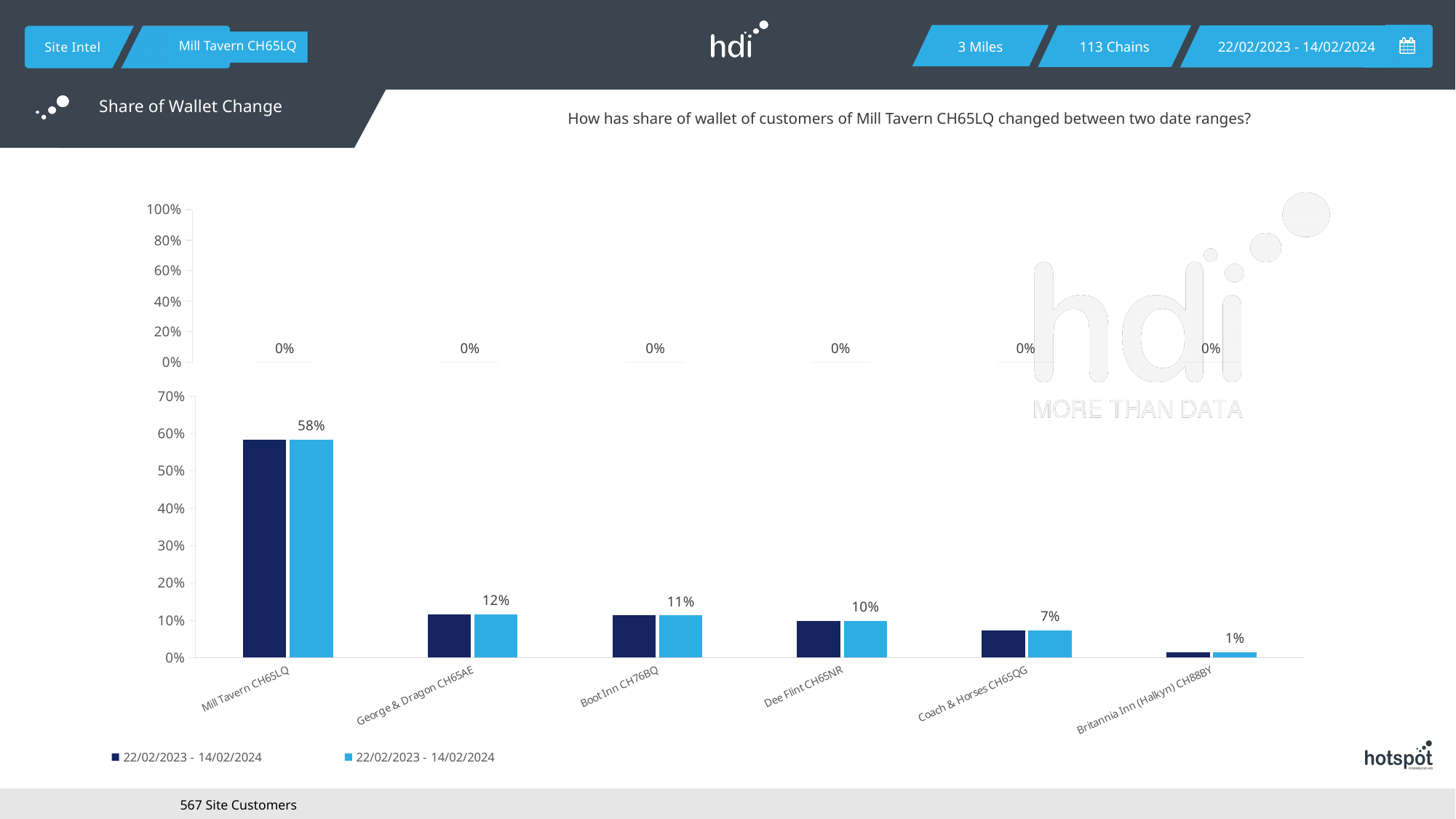
On the bottom chart, what is the difference between the labelled values for Mill Tavern CH65LQ and George & Dragon CH65AE? 46% How many series does the legend of the bottom chart list? 2 On the bottom chart, what is the labelled value for George & Dragon CH65AE? 12% How many sites are shown on the x axis of the bottom chart? 6 On the bottom chart, what is the labelled value for Coach & Horses CH65QG? 7% On the bottom chart, which site has the highest share of wallet? Mill Tavern CH65LQ On the bottom chart, is the value for Mill Tavern CH65LQ greater or less than 50%? greater On the bottom chart, which has the larger labelled value: Boot Inn CH76BQ or Dee Flint CH65NR? Boot Inn CH76BQ On the bottom chart, which site has the lowest share of wallet? Britannia Inn (Halkyn) CH88BY On the bottom chart, what is the labelled share of wallet value for Mill Tavern CH65LQ? 58% On the top chart, what is the labelled change value for Boot Inn CH76BQ? 0% What kind of chart is the bottom chart? Bar chart